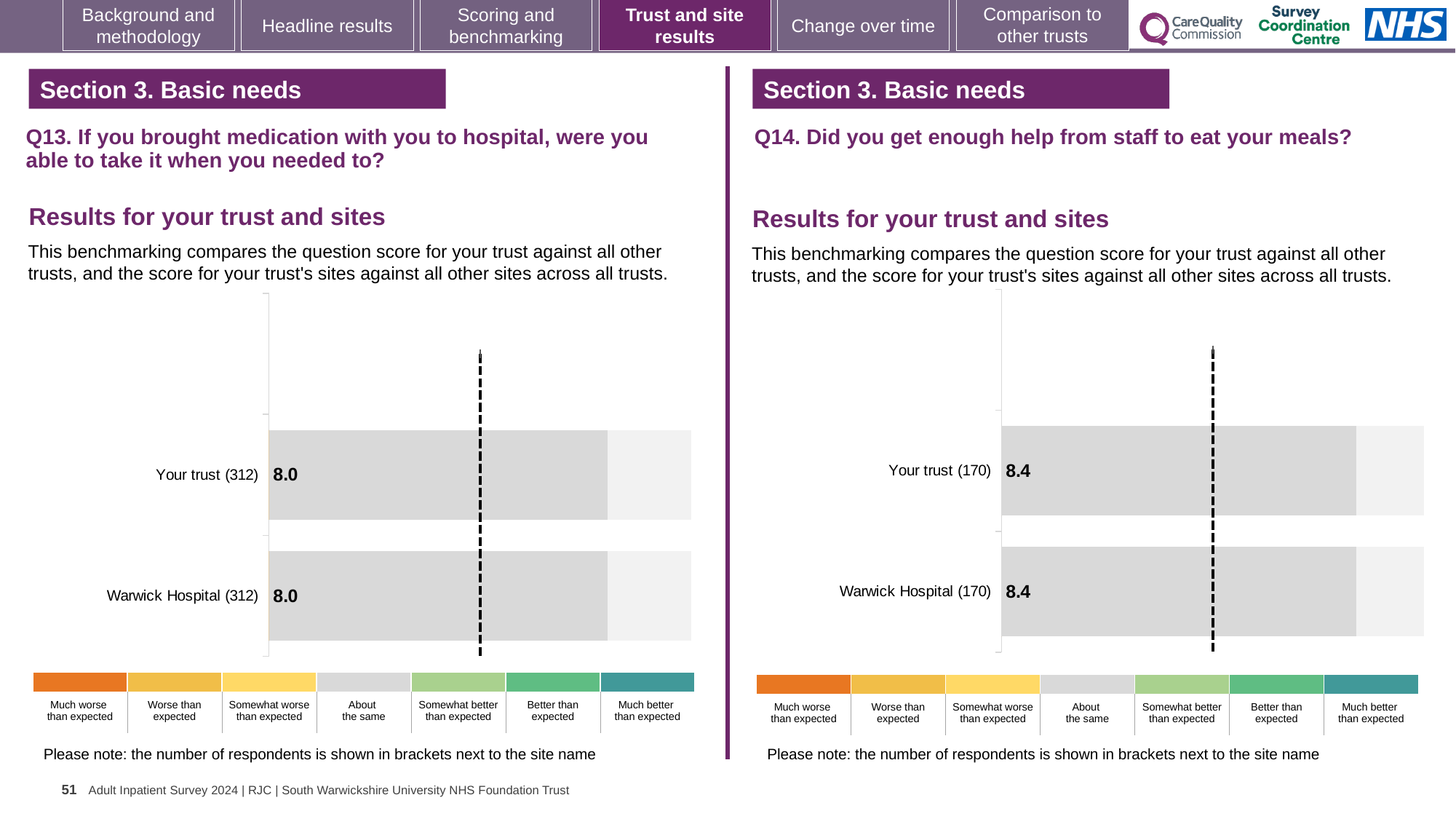
On the Q14 chart (right), how many respondents are shown in brackets for Your trust? 170 How many bars are plotted on the Q14 chart (right)? 2 On the Q13 chart (left), what is the difference between the Your trust score and the Warwick Hospital score? 0.0 On the Q14 chart (right), what is the score for Your trust? 8.4 On the Q13 chart (left), how many respondents are shown in brackets for Warwick Hospital? 312 On the Q13 chart (left), what is the score for Warwick Hospital? 8.0 What kind of chart is used on the Q13 chart (left)? Bar chart Is the Your trust score on the Q14 chart (right) larger or smaller than the Your trust score on the Q13 chart (left)? Larger On the Q13 chart (left), what is the score for Your trust? 8.0 On the Q14 chart (right), what is the score for Warwick Hospital? 8.4 On the Q14 chart (right), what is the difference between the Your trust score and the Warwick Hospital score? 0.0 How many bars are plotted on the Q13 chart (left)? 2